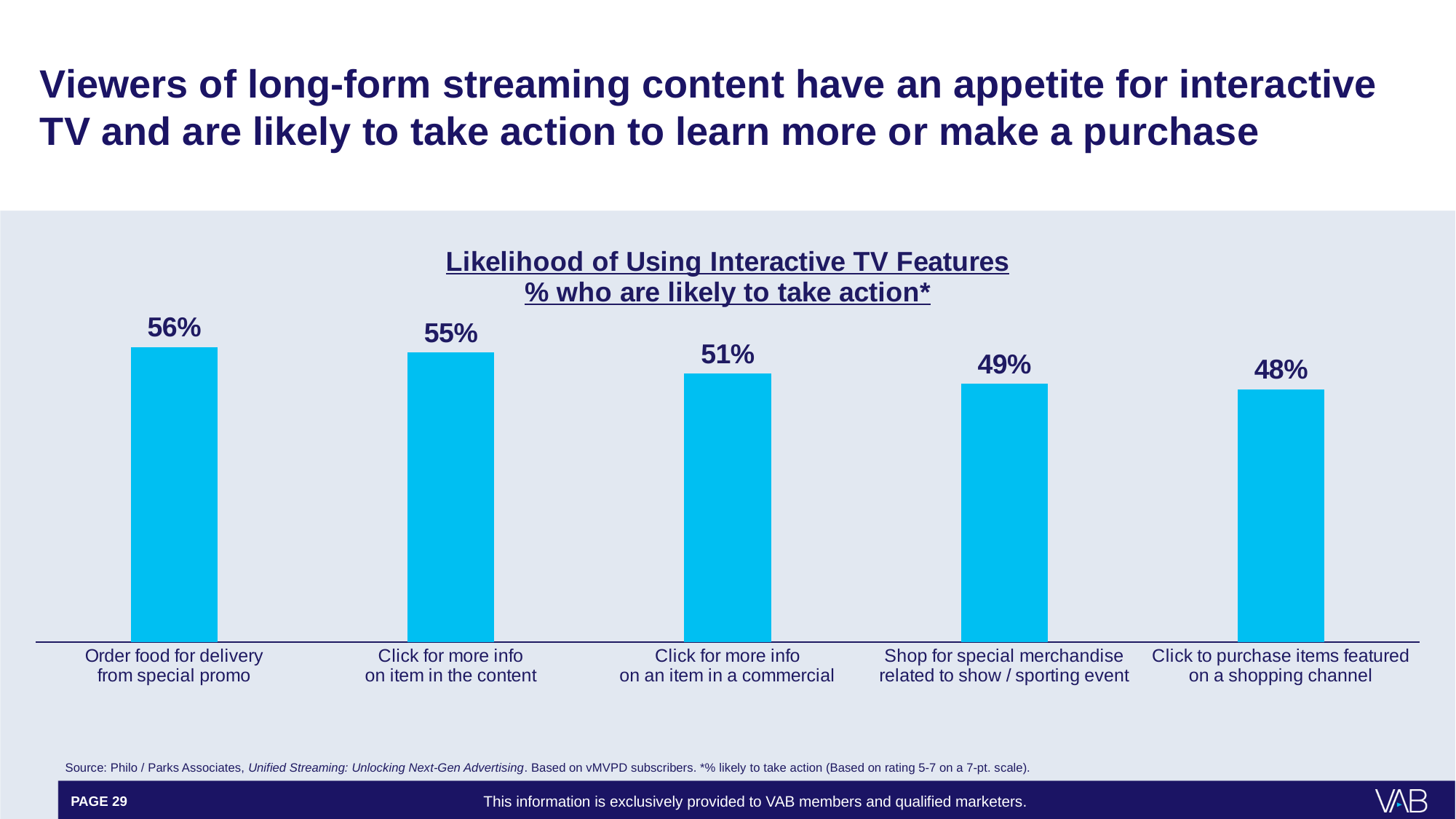
How many interactive TV features are shown in the chart? 5 Which interactive TV feature has the highest likelihood of use? Order food for delivery from special promo Do the values rise or fall from left to right across the chart? Fall What kind of chart is shown on the slide? Bar chart What is the difference between 'Click for more info on item in the content' and 'Click for more info on an item in a commercial'? 4 percentage points What is the value for 'Click for more info on an item in a commercial'? 51% What percentage of viewers are likely to order food for delivery from a special promo? 56% Which interactive TV feature has the lowest likelihood of use? Click to purchase items featured on a shopping channel Which is larger: the value for 'Click for more info on item in the content' or 'Shop for special merchandise related to show / sporting event'? Click for more info on item in the content What percentage are likely to click to purchase items featured on a shopping channel? 48% What is the value for 'Shop for special merchandise related to show / sporting event'? 49% What is the difference between 'Order food for delivery from special promo' and 'Click to purchase items featured on a shopping channel'? 8 percentage points